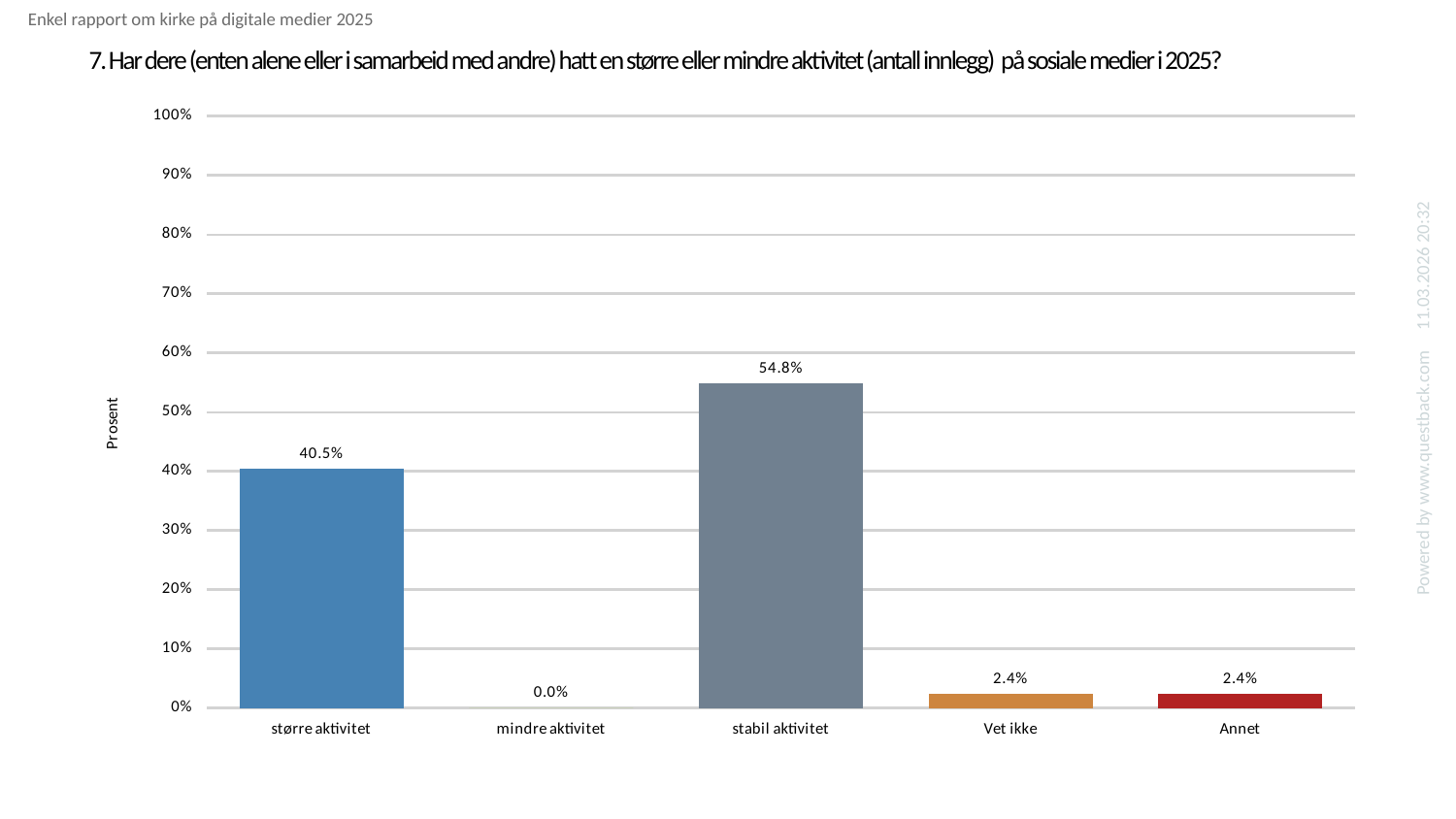
What is the label of the y axis? Prosent What is the value for 'Vet ikke'? 2.4% How many categories are shown on the x axis? 5 What is the value for 'stabil aktivitet'? 54.8% What kind of chart is shown on the slide? bar chart What is the difference between the values for 'stabil aktivitet' and 'større aktivitet'? 14.3% What is the value for 'mindre aktivitet'? 0.0% Which is larger, the value for 'større aktivitet' or the value for 'stabil aktivitet'? stabil aktivitet Is the value for 'større aktivitet' greater or less than 50%? less What is the value for 'større aktivitet'? 40.5% Which category has the lowest value? mindre aktivitet Which category has the highest value? stabil aktivitet